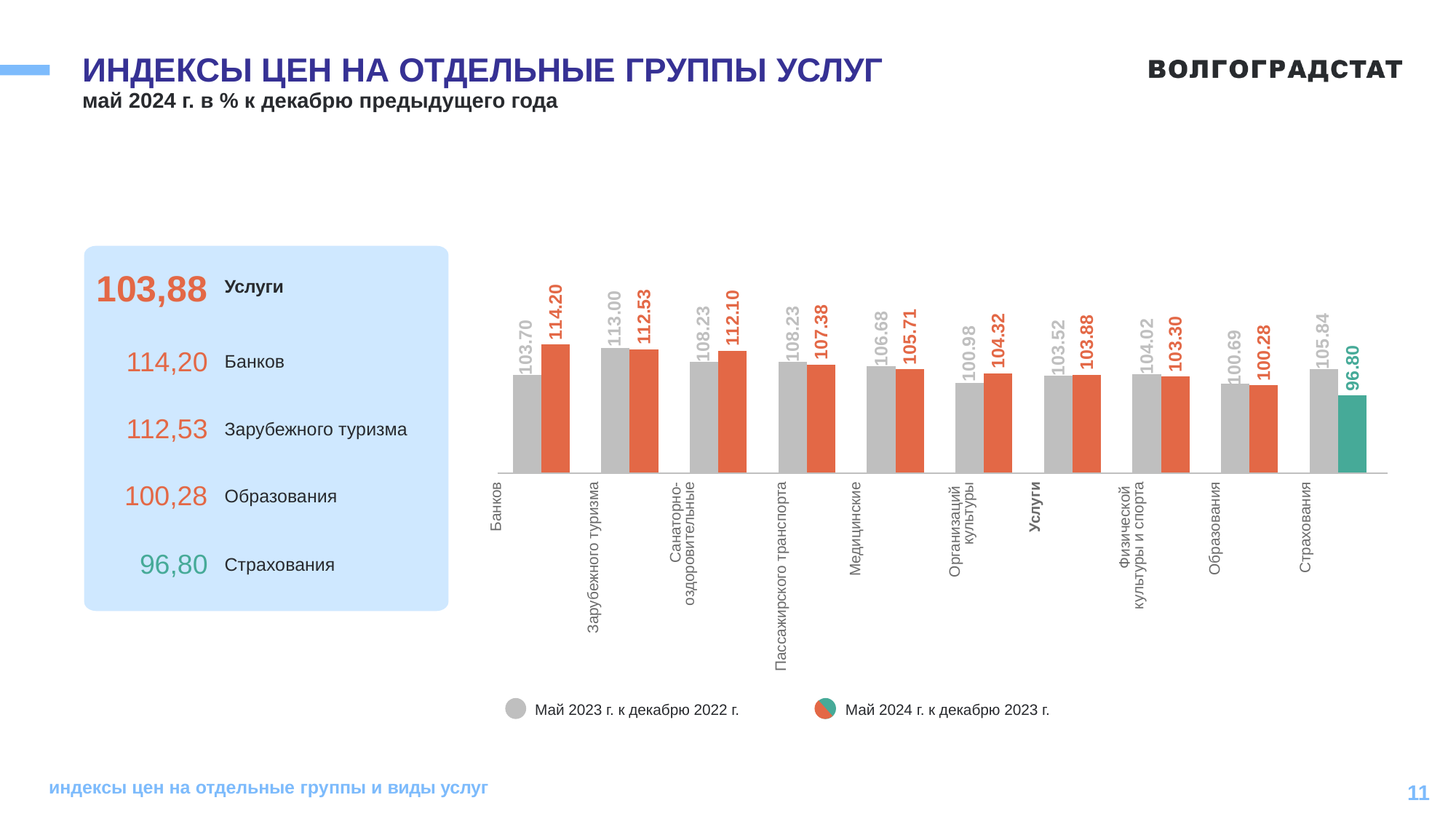
What colour is the bar for Страхования in the series 'Май 2024 г. к декабрю 2023 г.'? Green What is the value for Медицинские in the series 'Май 2024 г. к декабрю 2023 г.'? 105.71 Which category has the lowest value in the series 'Май 2024 г. к декабрю 2023 г.'? Страхования Which category has the highest value in the series 'Май 2024 г. к декабрю 2023 г.'? Банков How many series does the chart legend list? 2 How many service categories are shown along the x axis of the chart? 10 What type of chart is shown on the slide? Bar chart What is the difference between the 'Май 2024 г. к декабрю 2023 г.' and 'Май 2023 г. к декабрю 2022 г.' values for Банков? 10.50 Which category has the highest value in the series 'Май 2023 г. к декабрю 2022 г.'? Зарубежного туризма What is the value for Страхования in the series 'Май 2023 г. к декабрю 2022 г.'? 105.84 For Пассажирского транспорта, which series has the larger value: 'Май 2023 г. к декабрю 2022 г.' or 'Май 2024 г. к декабрю 2023 г.'? Май 2023 г. к декабрю 2022 г. What is the value for Банков in the series 'Май 2024 г. к декабрю 2023 г.'? 114.20